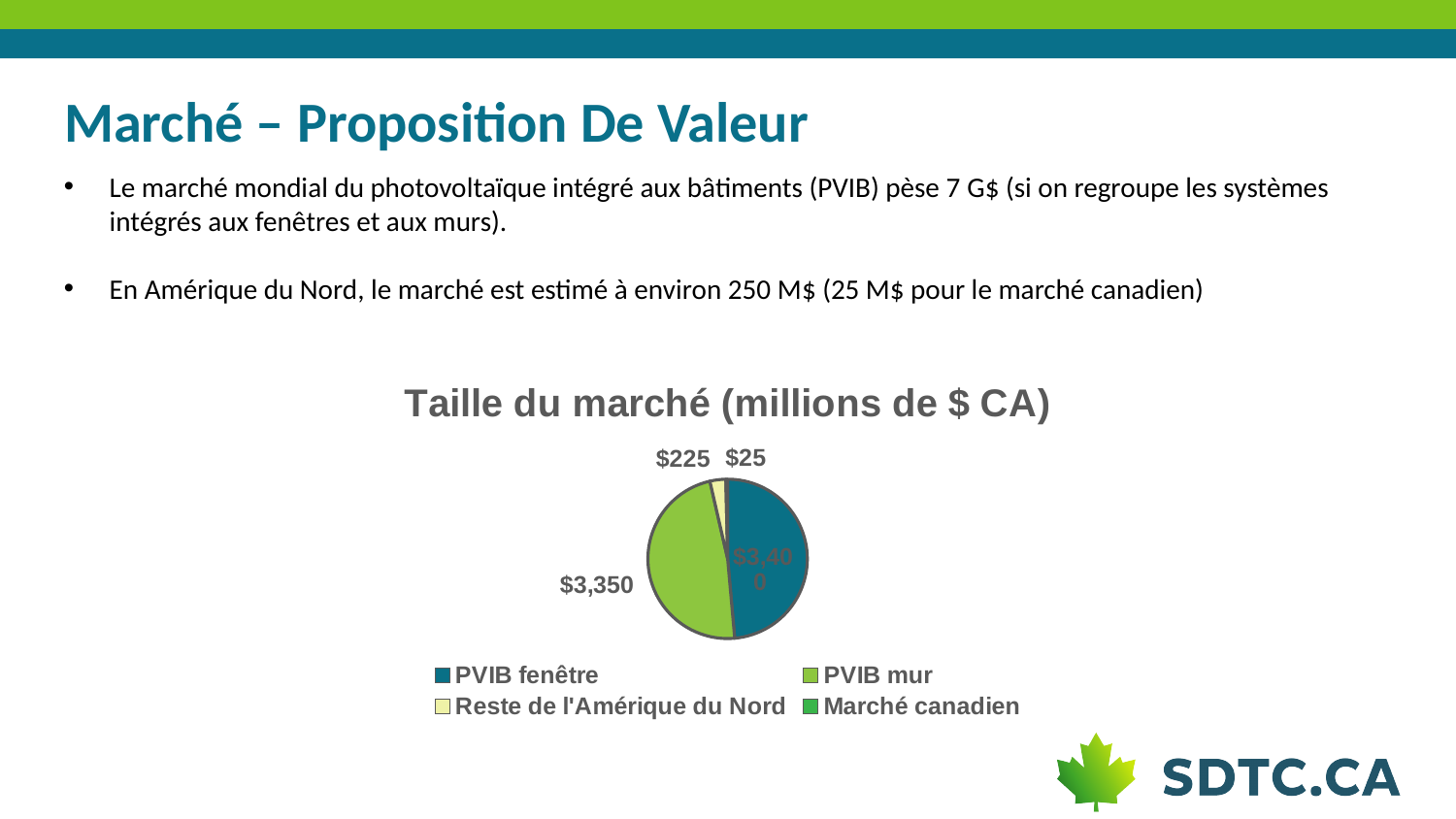
What is the value for PVIB mur in the pie chart? $3,350 What is the value for Marché canadien in the pie chart? $25 What is the difference between the values for Reste de l'Amérique du Nord and Marché canadien? $200 How many slices does the pie chart have? 4 How many entries does the legend list? 4 What kind of chart is shown on the slide? Pie chart Which category has the smallest slice in the pie chart? Marché canadien Which is larger, PVIB mur or Reste de l'Amérique du Nord? PVIB mur Which legend entry is shown in dark teal? PVIB fenêtre What is the difference between the values for PVIB mur and Reste de l'Amérique du Nord? $3,125 What is the title of the chart? Taille du marché (millions de $ CA) What is the value for Reste de l'Amérique du Nord in the pie chart? $225